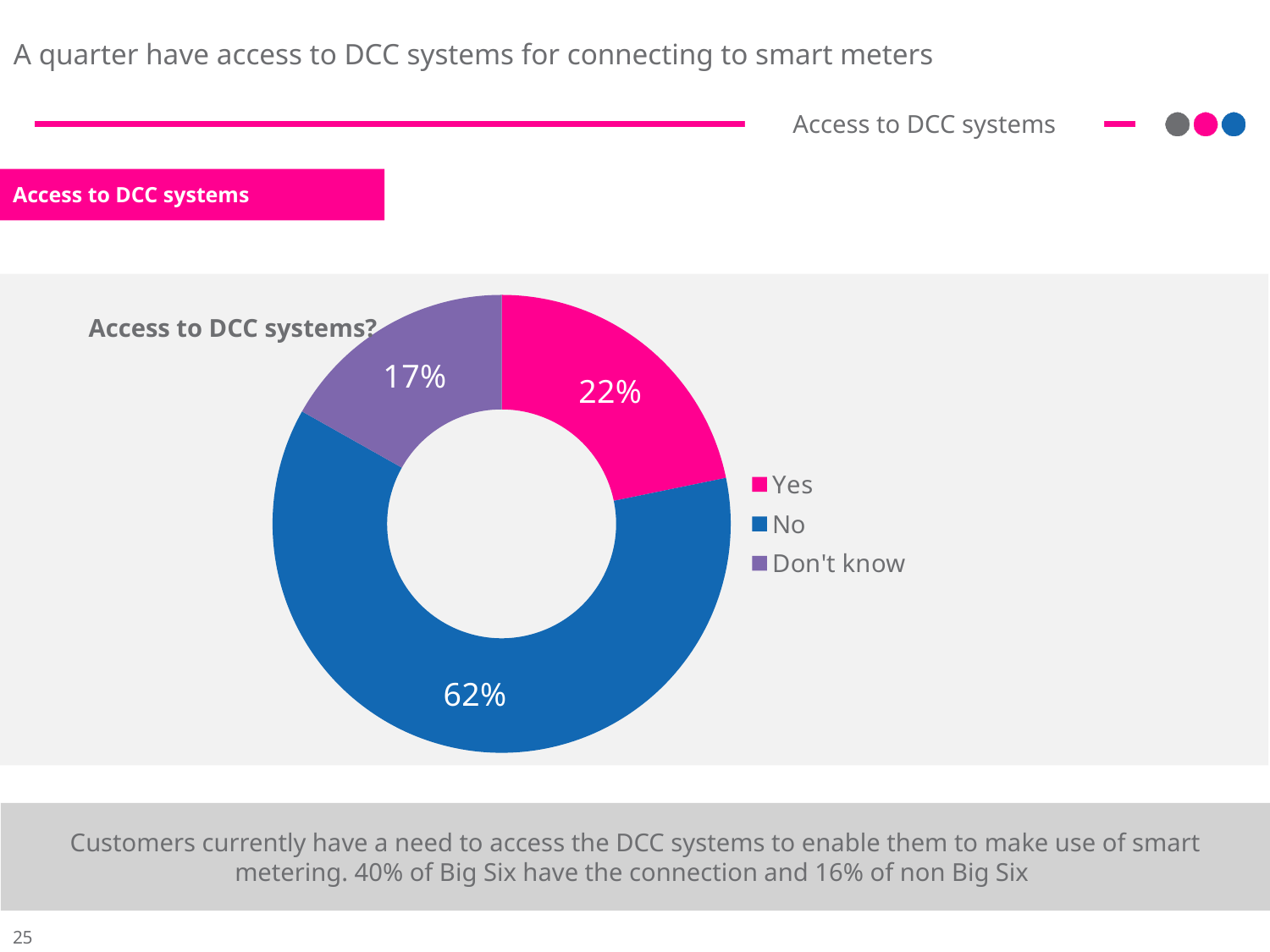
What percentage of respondents answered "No" to having access to DCC systems? 62% Which response category has the largest share of the chart? No Which colour represents the "No" category in the chart? Blue What percentage of respondents answered "Don't know" about access to DCC systems? 17% What kind of chart is shown on the slide? Pie chart (doughnut) What is the difference in percentage points between the "No" and "Yes" shares? 40 Which response category has the smallest share of the chart? Don't know What is the title of the chart? Access to DCC systems? What percentage of respondents answered "Yes" to having access to DCC systems? 22% Which is larger, the share for "Yes" or the share for "Don't know"? Yes How many categories does the chart show? 3 What is the difference in percentage points between the "Yes" and "Don't know" shares? 5